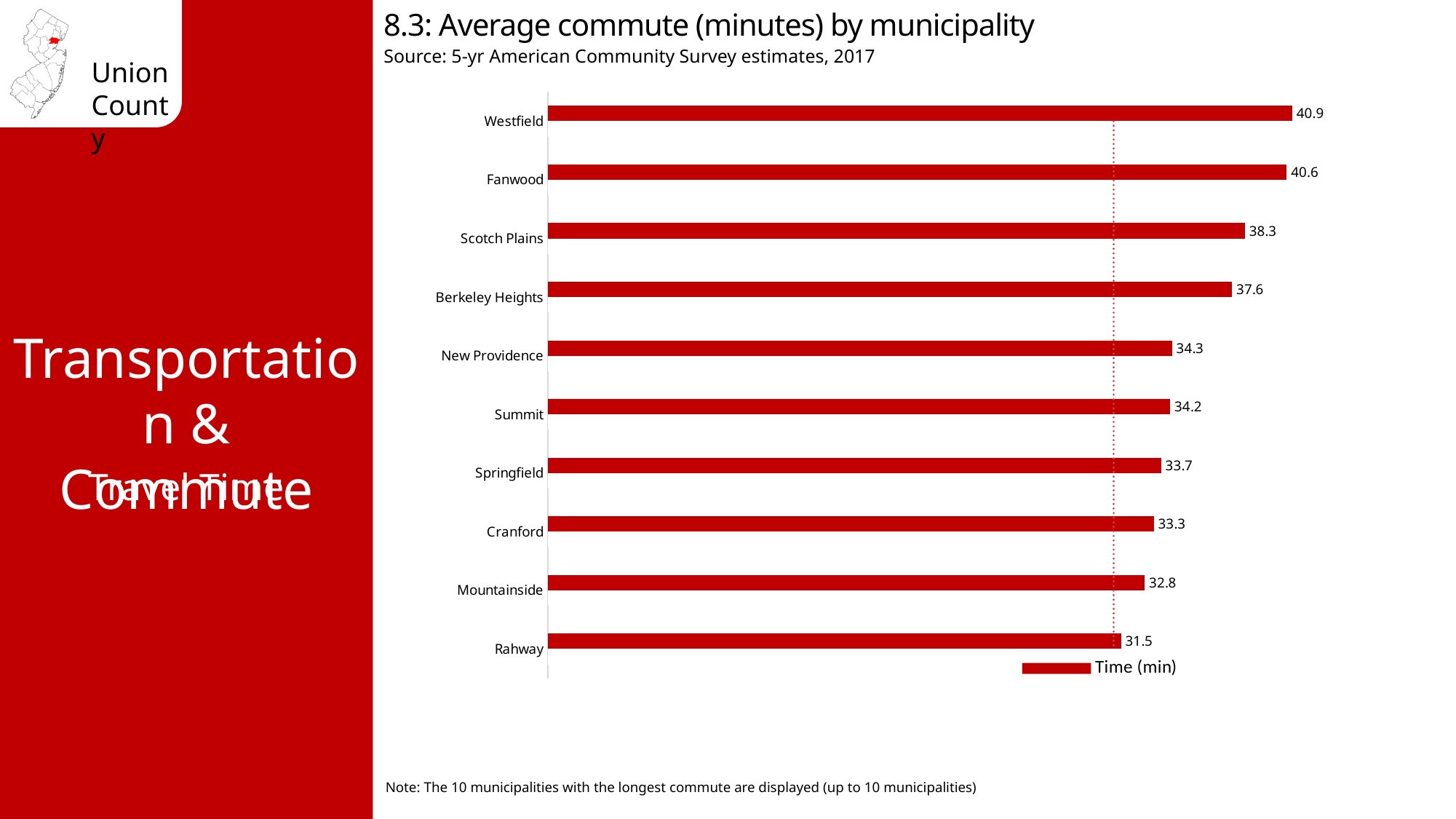
Which municipality has the longest average commute? Westfield What is the average commute time for Berkeley Heights? 37.6 Which has a longer average commute, Fanwood or Scotch Plains? Fanwood What is the difference in average commute time between Scotch Plains and Berkeley Heights? 0.7 Which municipality has the shortest average commute shown on the chart? Rahway What is the average commute time for Westfield? 40.9 What is the legend entry for the series shown on the chart? Time (min) What is the difference in average commute time between Westfield and Rahway? 9.4 What kind of chart is shown on the slide? Bar chart How many municipalities are shown on the chart? 10 Which has a longer average commute, Springfield or Cranford? Springfield What is the average commute time for Rahway? 31.5